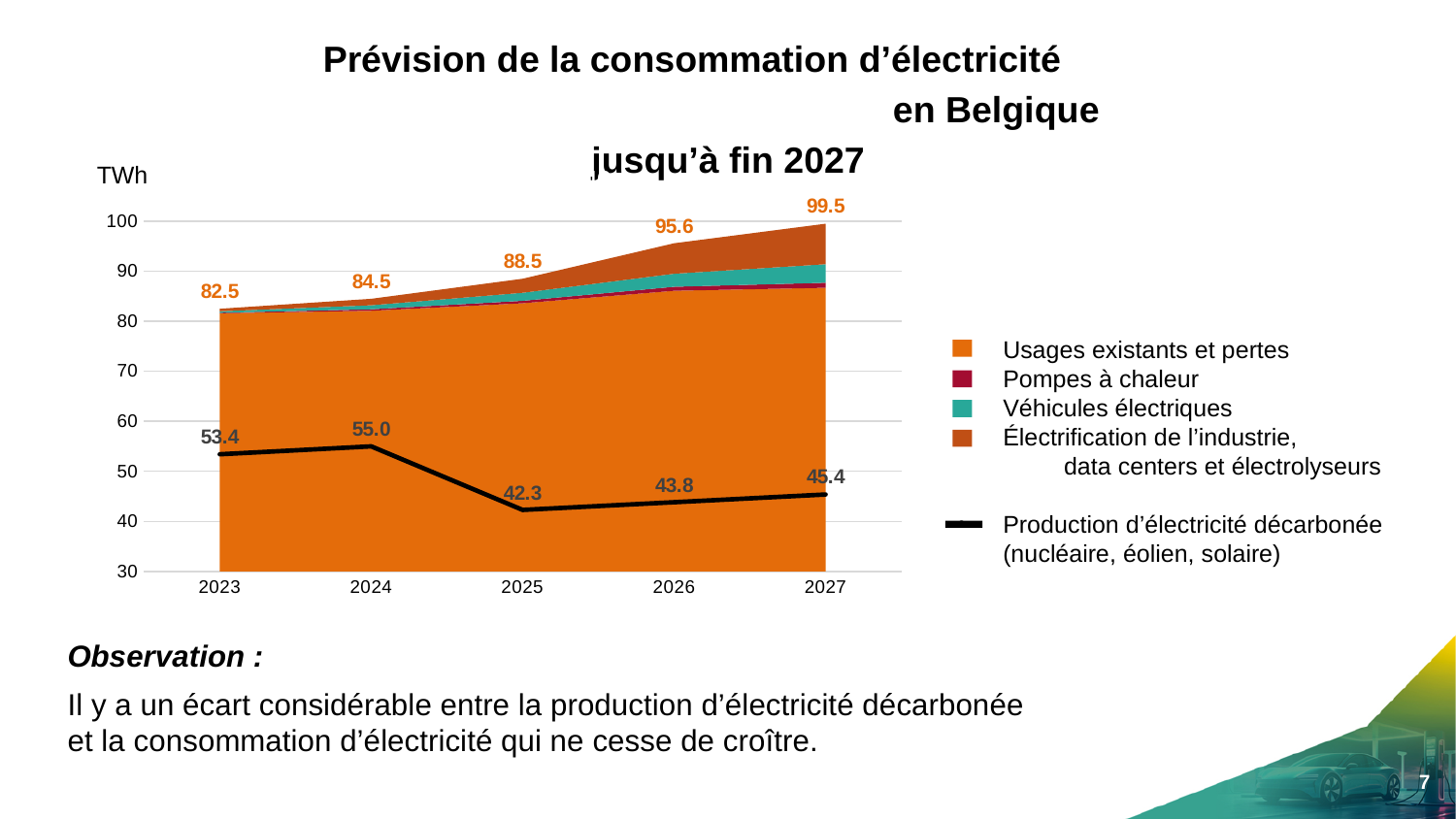
Which is larger: decarbonised production in 2024 or in 2026? 2024 What is the value of decarbonised electricity production (Production d'électricité décarbonée) in 2025? 42.3 How many entries does the legend list? 5 In which year is decarbonised electricity production highest? 2024 What is the total electricity consumption shown for 2023? 82.5 In which year is decarbonised electricity production lowest? 2025 Does total electricity consumption rise or fall from 2023 to 2027? rise What unit is shown on the y axis? TWh What is the total electricity consumption forecast for 2027? 99.5 What is the difference between total consumption and decarbonised production in 2027? 54.1 How many years are shown on the x axis? 5 By how much does total consumption increase from 2023 to 2027? 17.0